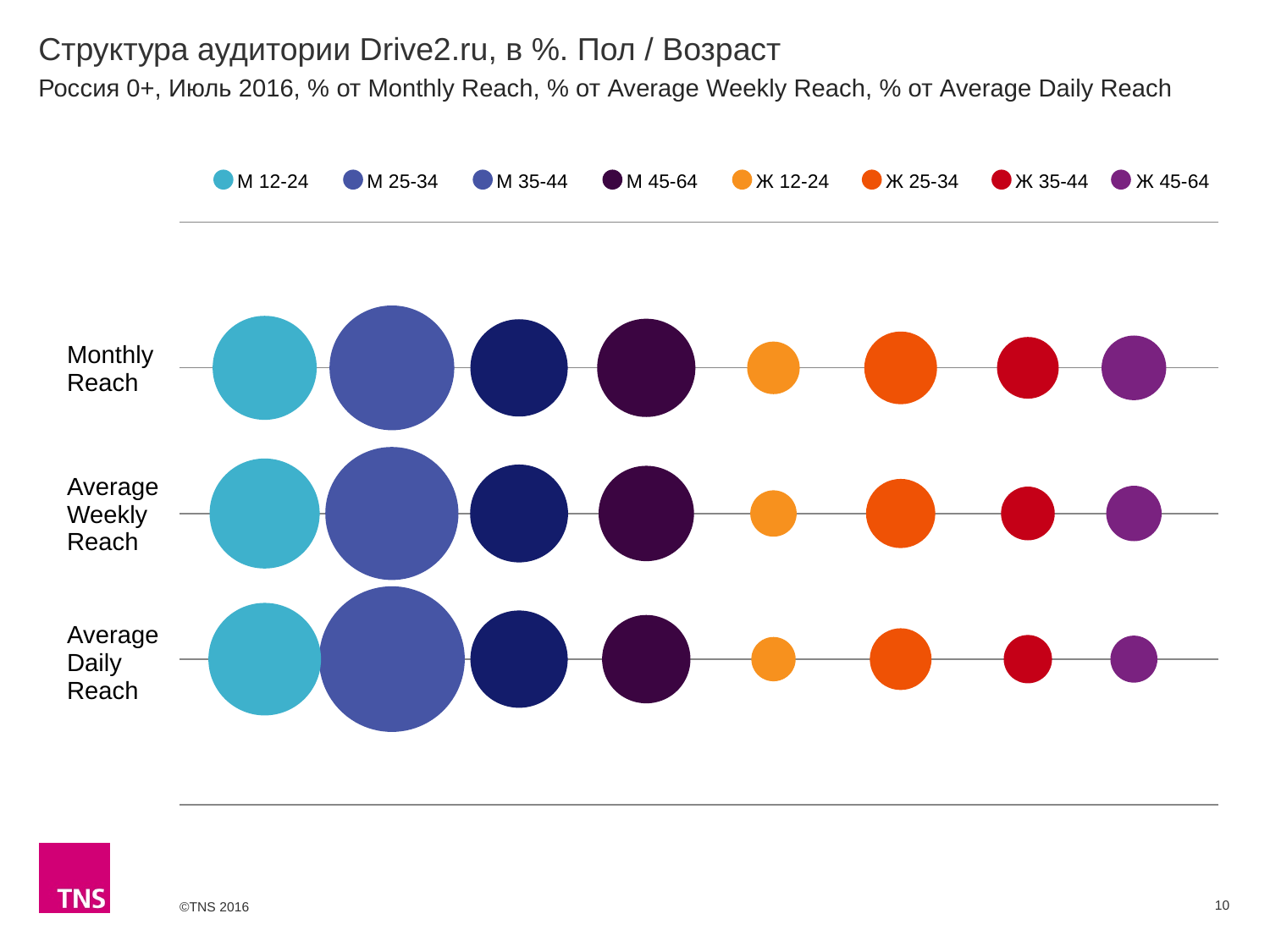
What month and year does the subtitle say the data refers to? Июль 2016 In the Average Weekly Reach row, which bubble is larger: М 25-34 or Ж 12-24? М 25-34 Which gender/age group has the largest bubble in the Monthly Reach row? М 25-34 What kind of chart is shown on the slide? bubble chart In the Monthly Reach row, which bubble is larger: Ж 25-34 or Ж 12-24? Ж 25-34 How many reach categories (rows) are plotted on the chart? 3 In the Average Daily Reach row, which bubble is larger: М 12-24 or М 45-64? М 12-24 Which gender/age group has the largest bubble in the Average Daily Reach row? М 25-34 Which website's audience structure is shown in the chart title? Drive2.ru How many series does the legend list? 8